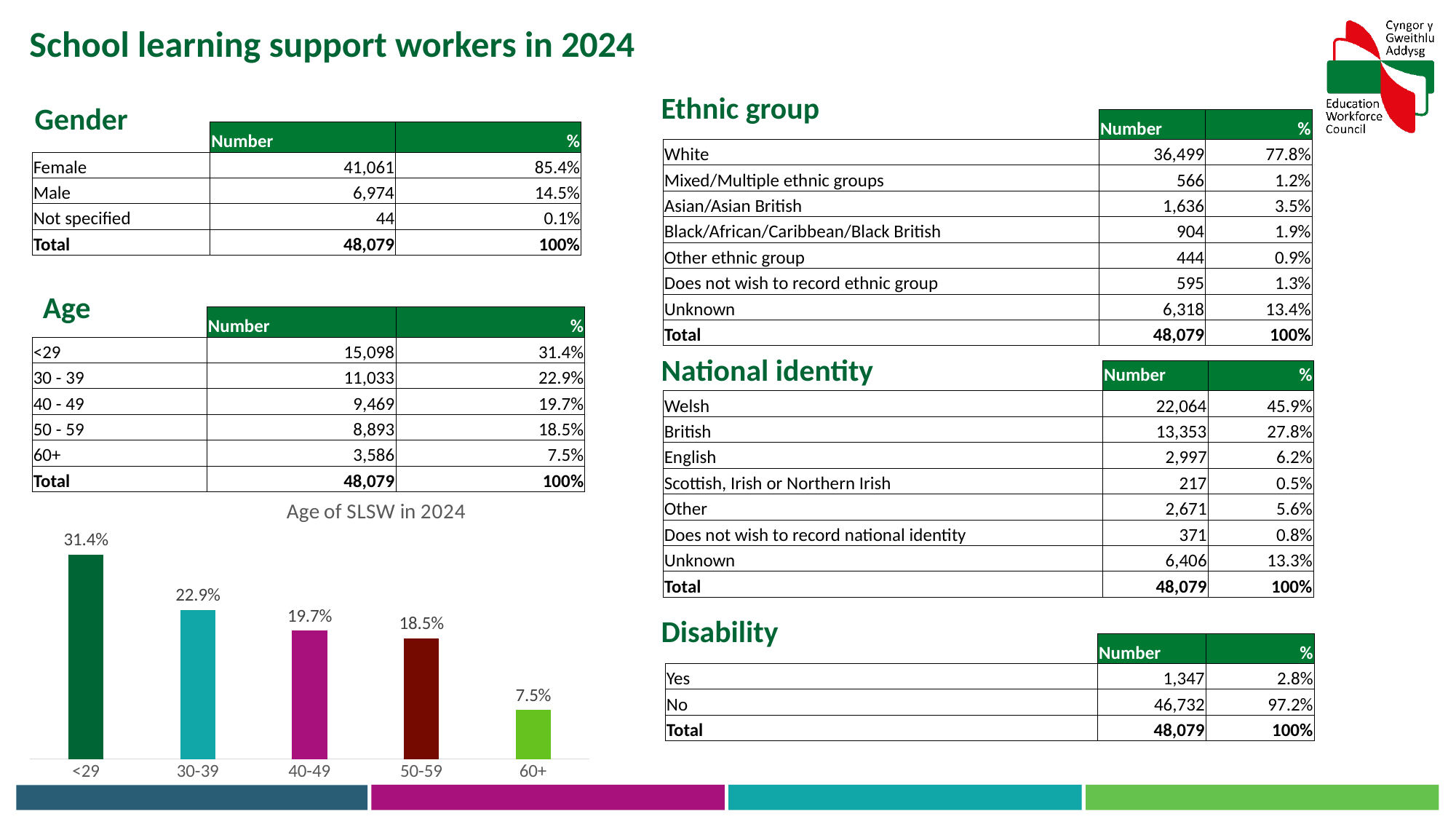
In the "Age of SLSW in 2024" chart, do the values rise or fall as you move from <29 to 60+ along the x axis? fall In the "Age of SLSW in 2024" chart, what is the value for the 60+ age group? 7.5% In the "Age of SLSW in 2024" chart, what is the difference between the values for 50-59 and 60+? 11.0% Which age group has the lowest value in the "Age of SLSW in 2024" chart? 60+ In the "Age of SLSW in 2024" chart, what is the value for the 40-49 age group? 19.7% In the "Age of SLSW in 2024" chart, what is the value for the <29 age group? 31.4% In the "Age of SLSW in 2024" chart, what is the difference between the values for <29 and 30-39? 8.5% Which age group has the highest value in the "Age of SLSW in 2024" chart? <29 How many age groups are shown in the "Age of SLSW in 2024" chart? 5 In the "Age of SLSW in 2024" chart, which is larger, the value for 30-39 or the value for 40-49? 30-39 What is the title of the chart on the slide? Age of SLSW in 2024 What kind of chart is "Age of SLSW in 2024"? bar chart